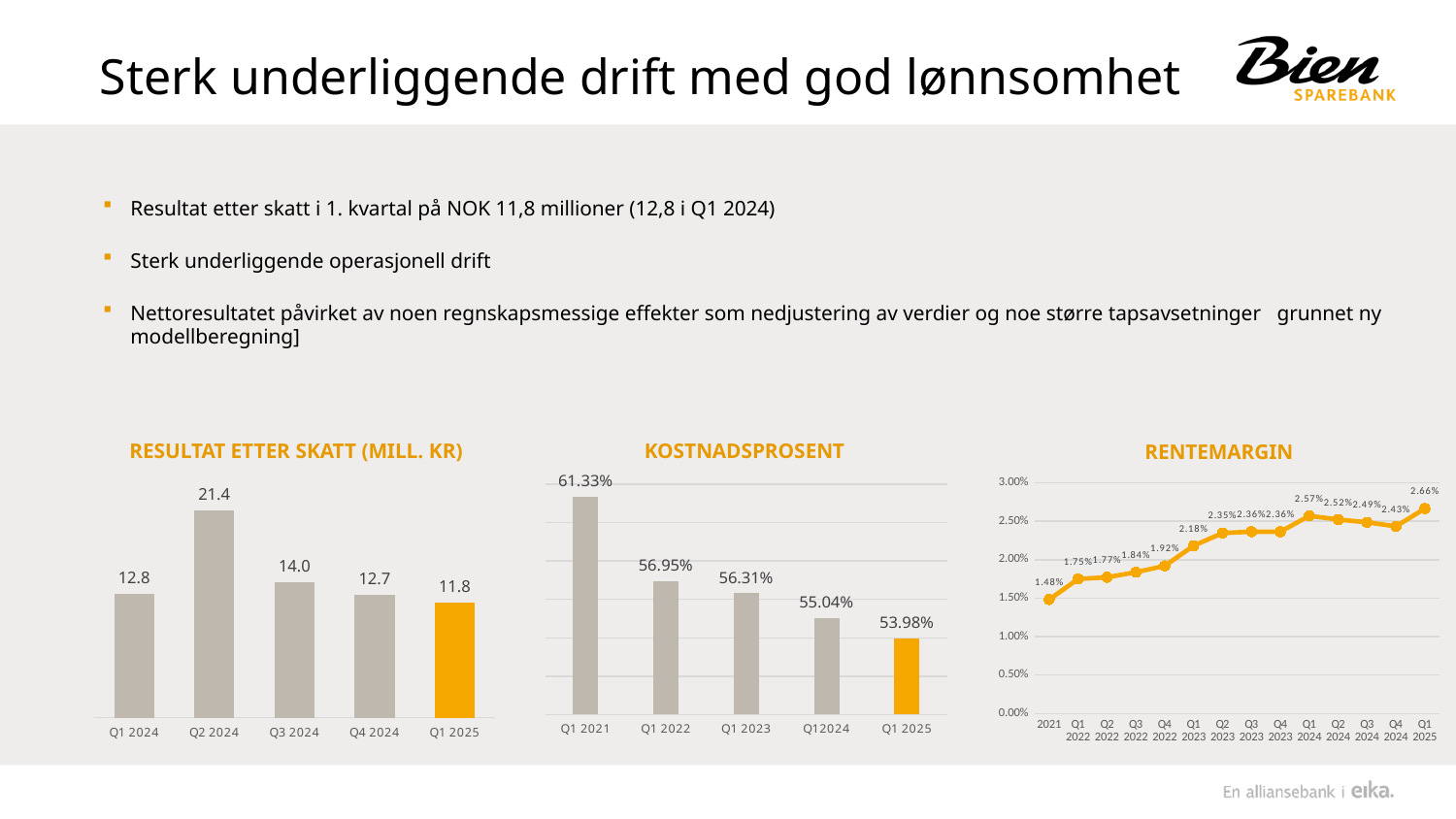
In the RESULTAT ETTER SKATT (MILL. KR) chart, which quarter has the lowest value? Q1 2025 In the KOSTNADSPROSENT chart, do the values rise or fall from Q1 2021 to Q1 2025? fall In the KOSTNADSPROSENT chart, which is larger, Q1 2022 or Q1 2025? Q1 2022 In the RESULTAT ETTER SKATT (MILL. KR) chart, how many quarters are shown? 5 In the RESULTAT ETTER SKATT (MILL. KR) chart, what is the difference between Q2 2024 and Q3 2024? 7.4 In the KOSTNADSPROSENT chart, what is the value for Q1 2023? 56.31% What kind of chart is the RENTEMARGIN chart? line chart In the KOSTNADSPROSENT chart, which quarter has the highest value? Q1 2021 In the RESULTAT ETTER SKATT (MILL. KR) chart, what is the value for Q2 2024? 21.4 In the RENTEMARGIN chart, what is the value for 2021? 1.48% In the RENTEMARGIN chart, what is the value for Q1 2025? 2.66% In the RENTEMARGIN chart, how many data points are plotted? 14